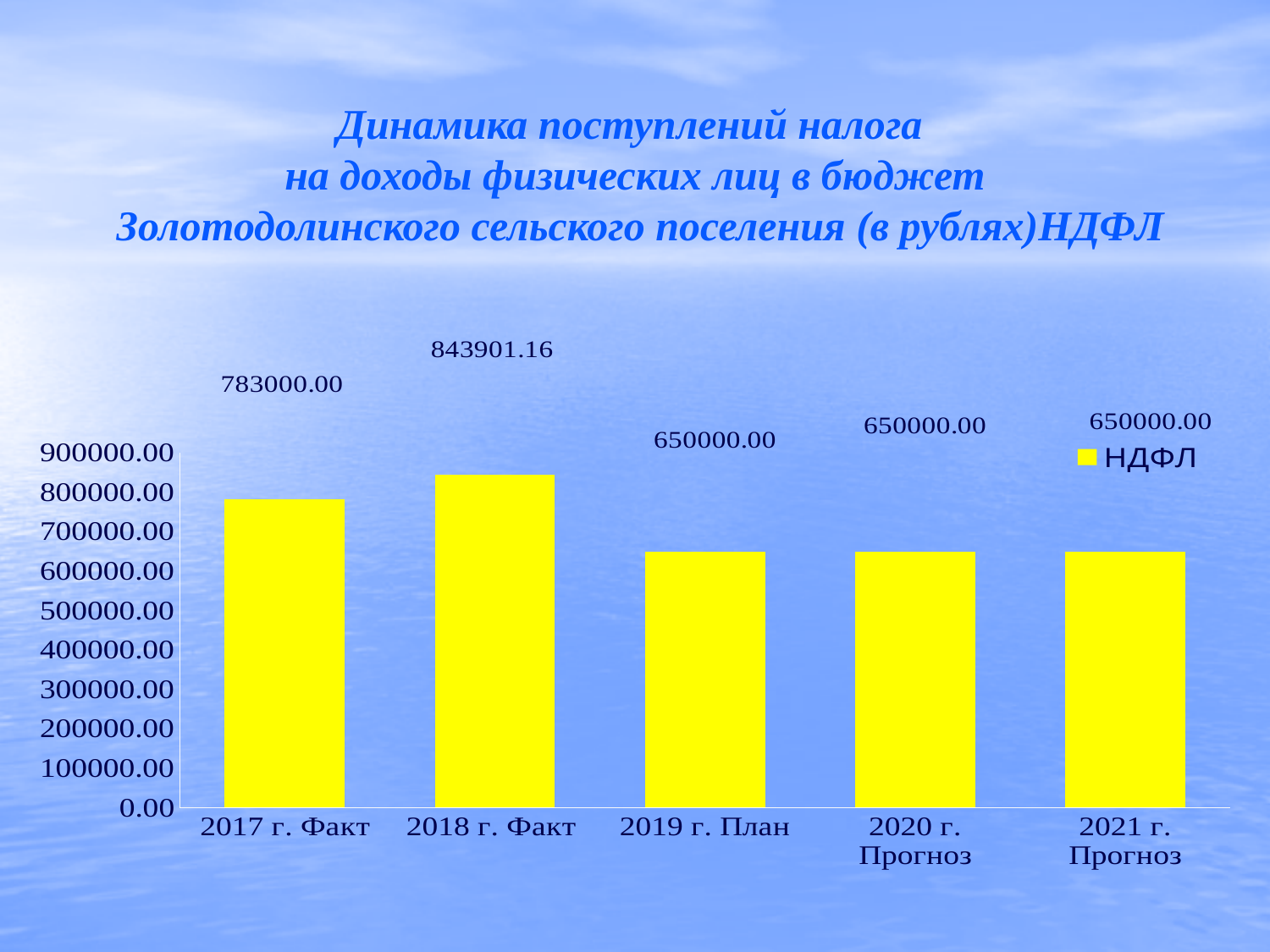
What is the value for 2017 г. Факт? 783000.00 What kind of chart is shown on the slide? bar chart What is the difference between the values for 2018 г. Факт and 2017 г. Факт? 60901.16 What is the value for 2019 г. План? 650000.00 Is the value for 2019 г. План greater or less than 700000.00? less How many series does the legend list? 1 What is the value for 2021 г. Прогноз? 650000.00 Which category has the highest value? 2018 г. Факт What is the value for 2018 г. Факт? 843901.16 What is the difference between the values for 2017 г. Факт and 2019 г. План? 133000.00 How many categories are shown on the x axis? 5 Which is larger, the value for 2017 г. Факт or the value for 2020 г. Прогноз? 2017 г. Факт